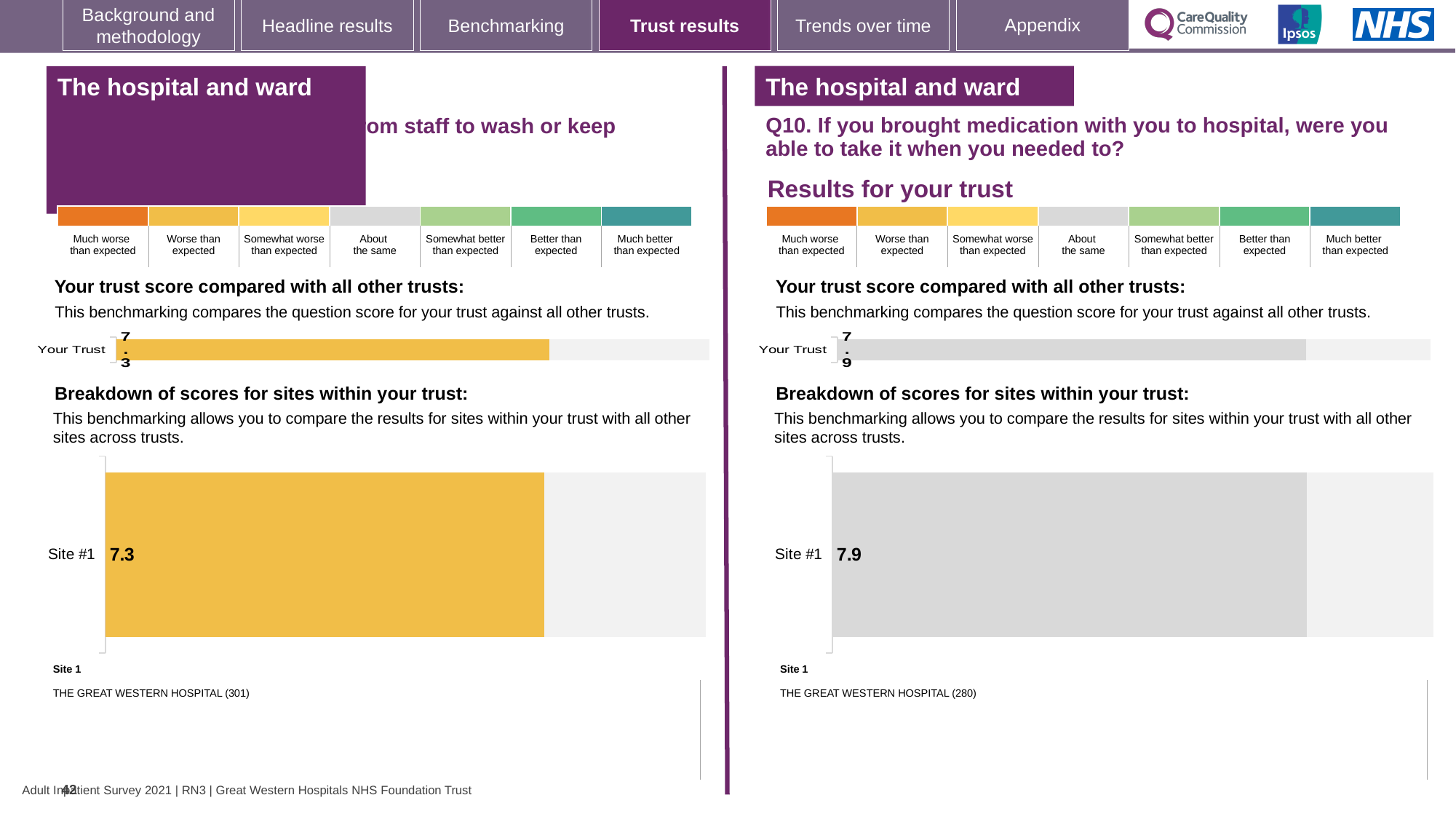
What colour is the Site #1 bar in the right-hand Q10 site breakdown chart? Grey What is the name of Site 1 listed beneath the site breakdown charts? THE GREAT WESTERN HOSPITAL In the left-hand 'Your trust score compared with all other trusts' chart, what is the value for 'Your Trust'? 7.3 In the left-hand site breakdown chart, what score is shown for Site #1? 7.3 In the right-hand site breakdown chart for Q10, what score is shown for Site #1? 7.9 What type of chart is used to show the 'Your Trust' score on each half of the slide? Bar chart How many sites are shown in the right-hand 'Breakdown of scores for sites within your trust' chart? 1 Which is larger: the Site #1 score in the left-hand chart or the Site #1 score in the right-hand Q10 chart? The right-hand Q10 chart (7.9) What is the difference between the Site #1 score in the right-hand Q10 chart (7.9) and the Site #1 score in the left-hand chart (7.3)? 0.6 In the right-hand chart for Q10 (medication), what is the score shown for 'Your Trust'? 7.9 Which is larger: the 'Your Trust' score in the left-hand chart or the 'Your Trust' score in the right-hand Q10 chart? The right-hand Q10 chart (7.9)